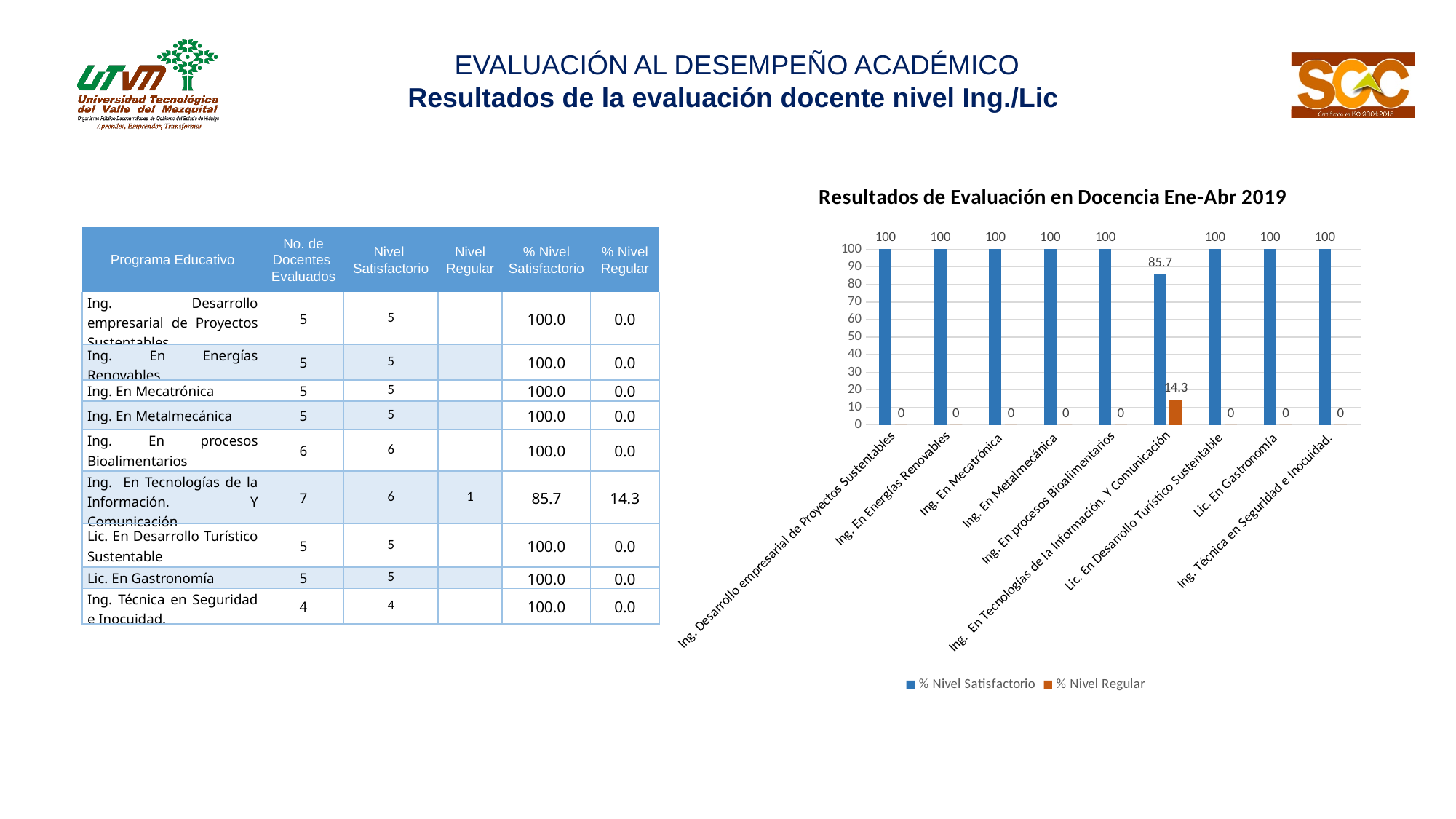
What is the % Nivel Satisfactorio value for Ing. En Tecnologías de la Información. Y Comunicación? 85.7 What is the title of the chart? Resultados de Evaluación en Docencia Ene-Abr 2019 What is the % Nivel Satisfactorio value for Lic. En Gastronomía? 100 What kind of chart is shown on the slide? Bar chart Which program has the lowest % Nivel Satisfactorio value? Ing. En Tecnologías de la Información. Y Comunicación Which is larger: the % Nivel Satisfactorio value for Ing. En Energías Renovables or for Ing. En Tecnologías de la Información. Y Comunicación? Ing. En Energías Renovables Which program has the highest % Nivel Regular value? Ing. En Tecnologías de la Información. Y Comunicación What is the difference between the % Nivel Satisfactorio values for Ing. En Metalmecánica and Ing. En Tecnologías de la Información. Y Comunicación? 14.3 What is the % Nivel Regular value for Ing. En Tecnologías de la Información. Y Comunicación? 14.3 What is the % Nivel Regular value for Ing. En Mecatrónica? 0 How many series does the chart legend list? 2 How many educational programs (categories) are shown on the chart's x axis? 9